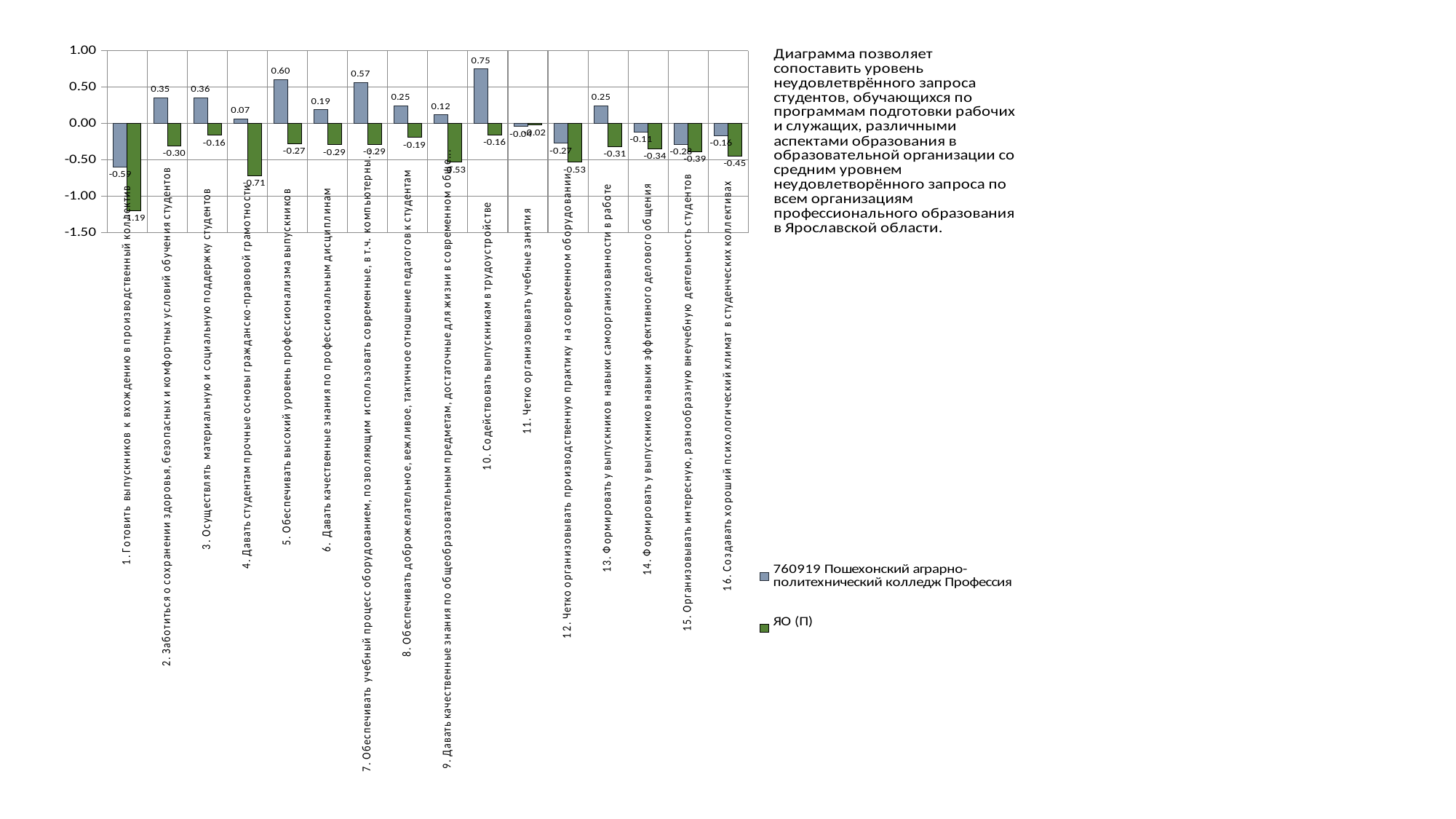
How many categories are plotted along the x axis? 16 Is the 'ЯО (П)' value for category 9 (Давать качественные знания по общеобразовательным предметам) greater or less than -0.50? less What is the value for the series '760919 Пошехонский аграрно-политехнический колледж Профессия' in category 10 (Содействовать выпускникам в трудоустройстве)? 0.75 What kind of chart is shown on the slide? bar chart What is the value for the series 'ЯО (П)' in category 4 (Давать студентам прочные основы гражданско-правовой грамотности)? -0.71 Which category has the lowest value for the series 'ЯО (П)'? 1. Готовить выпускников к вхождению в производственный коллектив What is the value for the series 'ЯО (П)' in category 16 (Создавать хороший психологический климат в студенческих коллективах)? -0.45 In category 5 (Обеспечивать высокий уровень профессионализма выпускников), what is the difference between the college series value and the 'ЯО (П)' value? 0.87 In category 12 (Четко организовывать производственную практику на современном оборудовании), what is the difference between the college series value and the 'ЯО (П)' value? 0.26 How many series does the legend list? 2 For the college series, which is larger: the value in category 10 or the value in category 5? category 10 Which category has the highest value for the series '760919 Пошехонский аграрно-политехнический колледж Профессия'? 10. Содействовать выпускникам в трудоустройстве